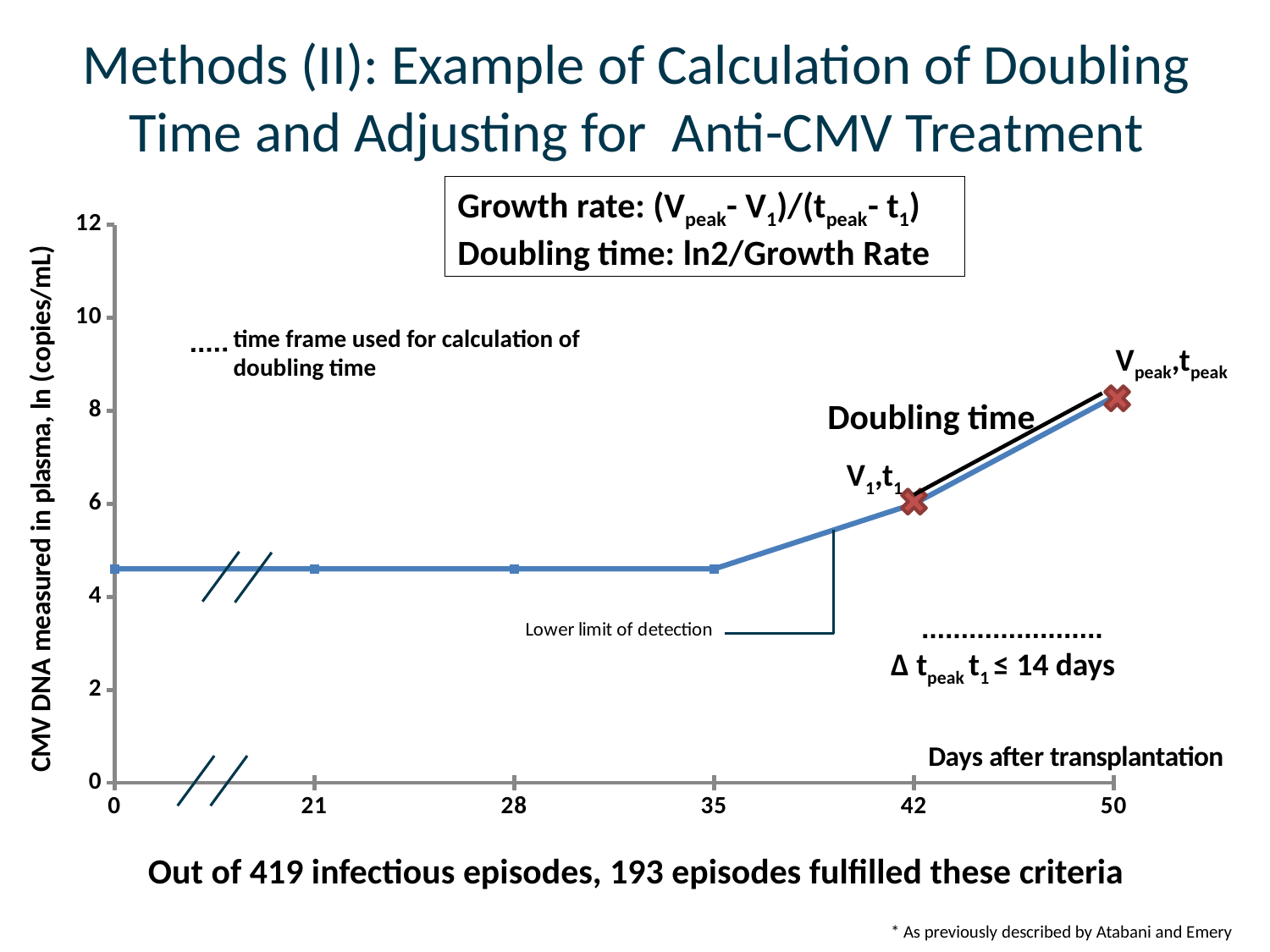
Do the plotted values rise or fall between day 35 and day 50? rise Is the plotted value at day 28 greater or less than 8? less Which has the larger plotted value, day 42 or day 50? day 50 What is the label of the y axis? CMV DNA measured in plasma, ln (copies/mL) Is the plotted value at day 42 greater or less than 4? greater At which day after transplantation is the plotted CMV DNA value highest? 50 Is the plotted value at day 50 greater or less than 6? greater What kind of chart is shown on the slide? line chart What is the label of the x axis? Days after transplantation How many data points are plotted on the line? 6 Which has the larger plotted value, day 35 or day 42? day 42